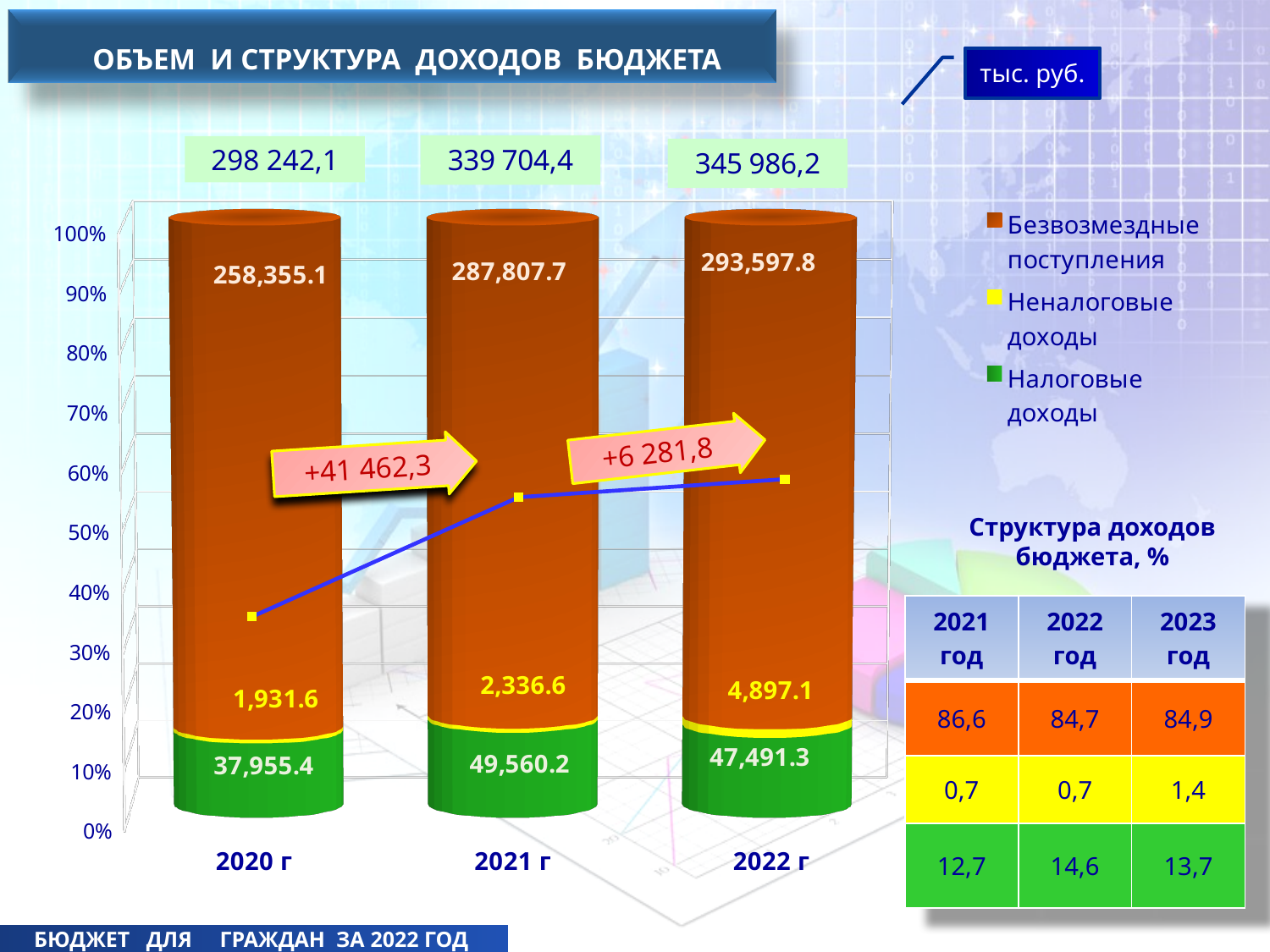
What is the total budget income shown above the bar for 2021 г? 339 704,4 What is the value of Налоговые доходы for 2021 г? 49,560.2 What is the value of Безвозмездные поступления for 2020 г? 258,355.1 How many years are shown on the x axis of the chart? 3 What is the value of Неналоговые доходы for 2022 г? 4,897.1 In which year is Неналоговые доходы lowest? 2020 г Which is larger: Налоговые доходы in 2021 г or in 2022 г? 2021 г Which colour represents Налоговые доходы in the legend? Green What kind of chart is shown on the slide? Stacked bar chart How many series does the legend list? 3 What is the difference in Налоговые доходы between 2021 г and 2020 г? 11,604.8 In which year is Безвозмездные поступления highest? 2022 г